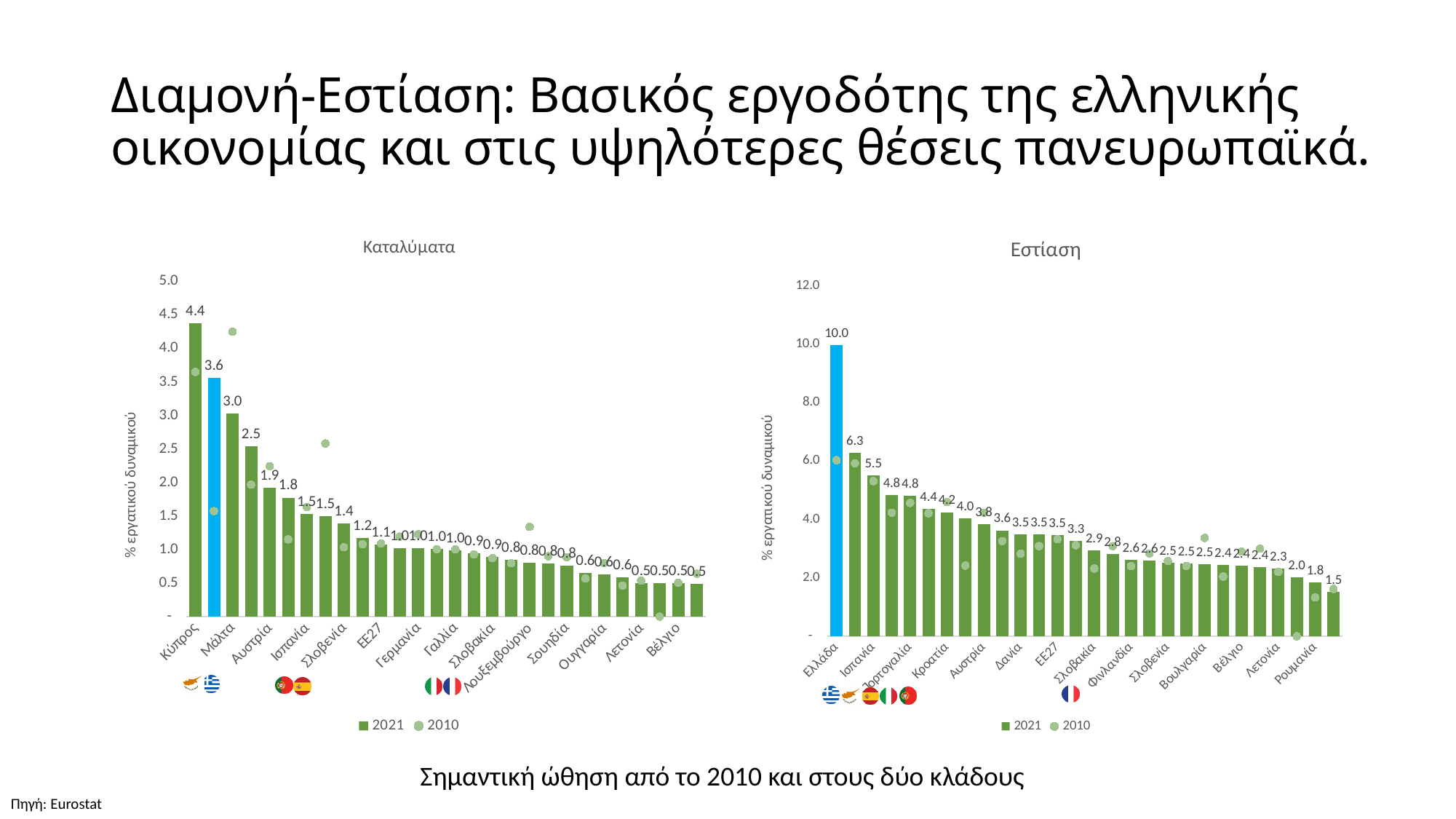
In the 'Εστίαση' chart, what is the difference between the first bar (10.0) and the second bar (6.3)? 3.7 What type of chart is the 'Καταλύματα' chart? bar chart In the 'Εστίαση' chart, do the 2021 bar values rise or fall from left to right? fall In the 'Καταλύματα' chart, what is the 2021 value for Κύπρος? 4.4 Which is larger: the 2021 value for Ελλάδα in the 'Εστίαση' chart or the 2021 value for Κύπρος in the 'Καταλύματα' chart? Ελλάδα in the 'Εστίαση' chart What is the lowest 2021 bar value shown in the 'Εστίαση' chart? 1.5 What are the two legend entries in the 'Καταλύματα' chart? 2021 and 2010 In the 'Καταλύματα' chart, what is the value of the blue highlighted bar? 3.6 In the 'Καταλύματα' chart, which category has the highest 2021 bar? Κύπρος In the 'Εστίαση' chart, what is the 2021 value for Ελλάδα? 10.0 In the 'Εστίαση' chart, which category has the highest 2021 bar? Ελλάδα How many series does the legend of the 'Εστίαση' chart list? 2